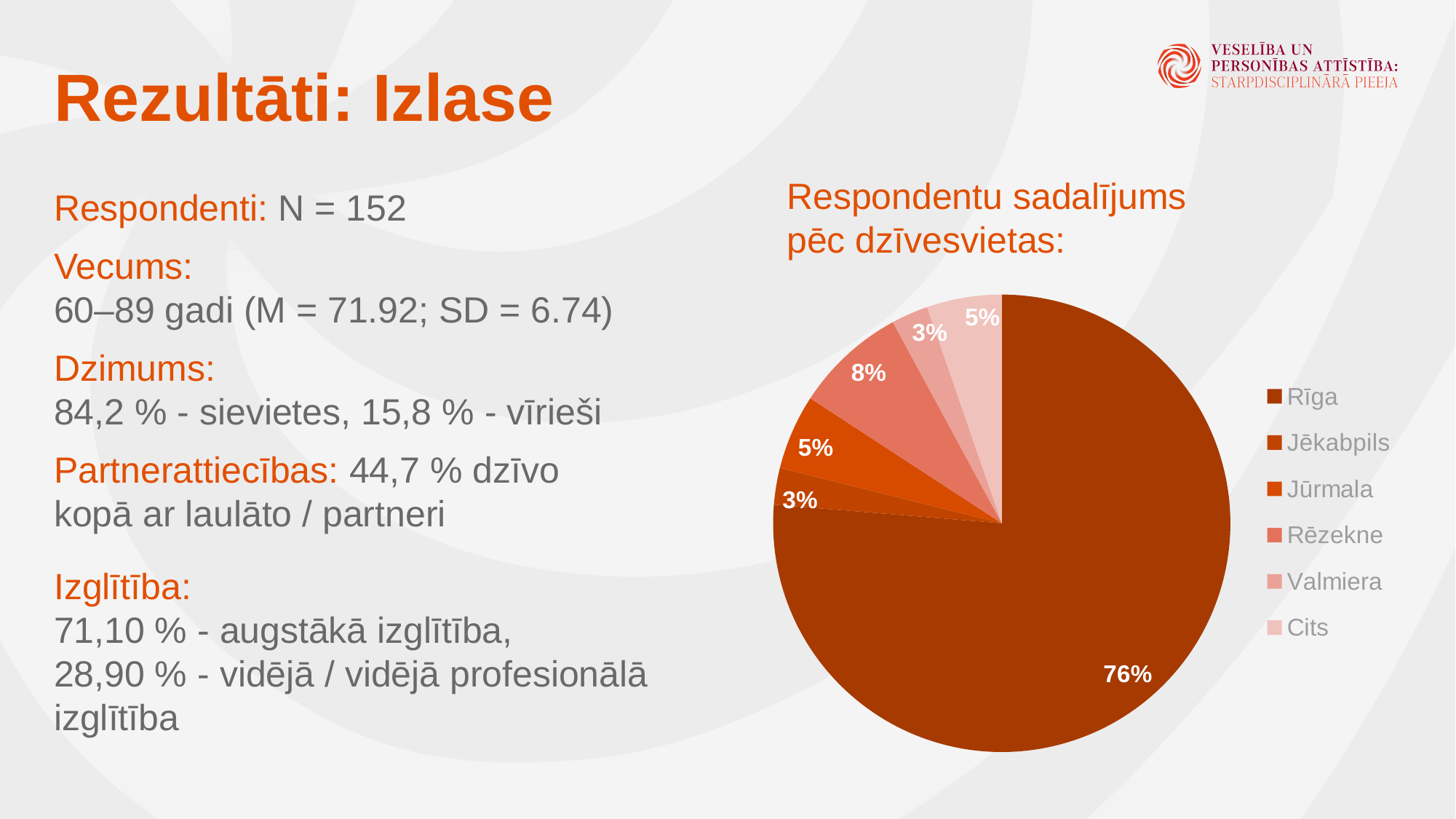
What share of respondents live in Rēzekne? 8% Which category is listed last in the legend? Cits What kind of chart is shown on the slide? pie chart Which place of residence has the largest share of respondents? Rīga What is the combined share of Jēkabpils and Valmiera? 6% What is the difference in percentage points between the Rīga slice and the Rēzekne slice? 68 Which slice is larger, Rēzekne or Jūrmala? Rēzekne How many categories does the legend of the pie chart list? 6 What share of respondents live in Rīga? 76% What is the title of the chart? Respondentu sadalījums pēc dzīvesvietas: What share of respondents live in Valmiera? 3% What share of respondents live in Jūrmala? 5%